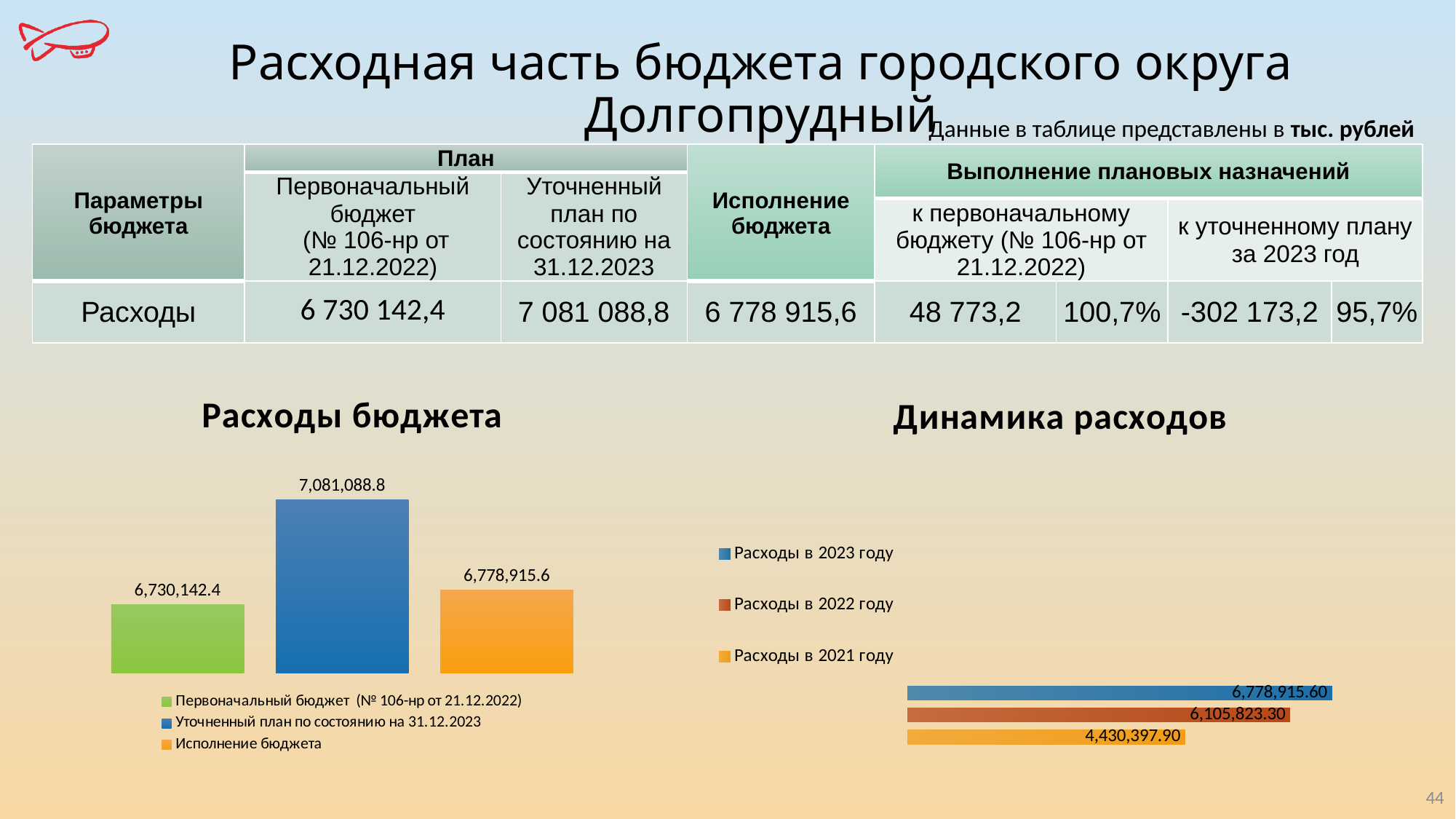
In the 'Расходы бюджета' chart, what is the value for 'Уточненный план по состоянию на 31.12.2023'? 7,081,088.8 In the 'Динамика расходов' chart, what is the value for 'Расходы в 2022 году'? 6,105,823.30 What kind of chart is 'Динамика расходов'? Bar chart In the 'Динамика расходов' chart, which is larger: 'Расходы в 2022 году' or 'Расходы в 2021 году'? Расходы в 2022 году In the 'Расходы бюджета' chart, how many series does the legend list? 3 In the 'Динамика расходов' chart, what is the value for 'Расходы в 2021 году'? 4,430,397.90 In the 'Расходы бюджета' chart, what is the value for 'Исполнение бюджета'? 6,778,915.6 In the 'Расходы бюджета' chart, what is the difference between 'Уточненный план по состоянию на 31.12.2023' and 'Исполнение бюджета'? 302,173.2 In the 'Динамика расходов' chart, which series has the highest value? Расходы в 2023 году In the 'Динамика расходов' chart, what is the difference between 'Расходы в 2023 году' and 'Расходы в 2022 году'? 673,092.30 In the 'Расходы бюджета' chart, which series has the highest value? Уточненный план по состоянию на 31.12.2023 In the 'Расходы бюджета' chart, which series has the lowest value? Первоначальный бюджет (№ 106-нр от 21.12.2022)